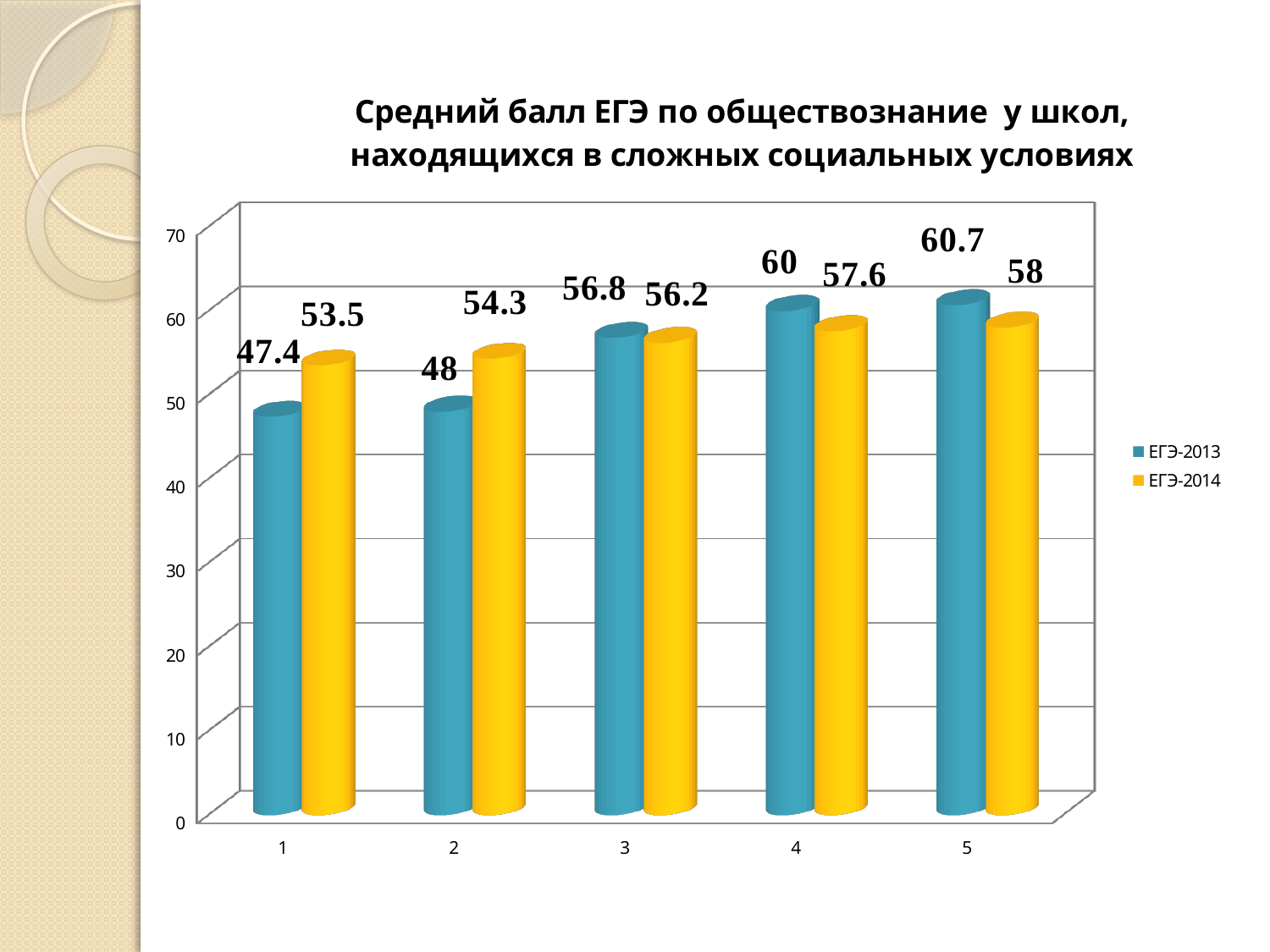
What is the ЕГЭ-2013 value for category 1? 47.4 Which category has the highest ЕГЭ-2013 value? 5 What is the ЕГЭ-2013 value for category 5? 60.7 How many categories are shown on the x axis? 5 Which category has the lowest ЕГЭ-2014 value? 1 Do the ЕГЭ-2013 values rise or fall from category 1 to category 5? rise For category 5, which series has the larger value, ЕГЭ-2013 or ЕГЭ-2014? ЕГЭ-2013 What is the difference between the ЕГЭ-2014 and ЕГЭ-2013 values for category 1? 6.1 What is the ЕГЭ-2014 value for category 4? 57.6 Is the ЕГЭ-2013 value for category 2 greater or less than 50? less What kind of chart is shown on the slide? bar chart How many series does the legend list? 2